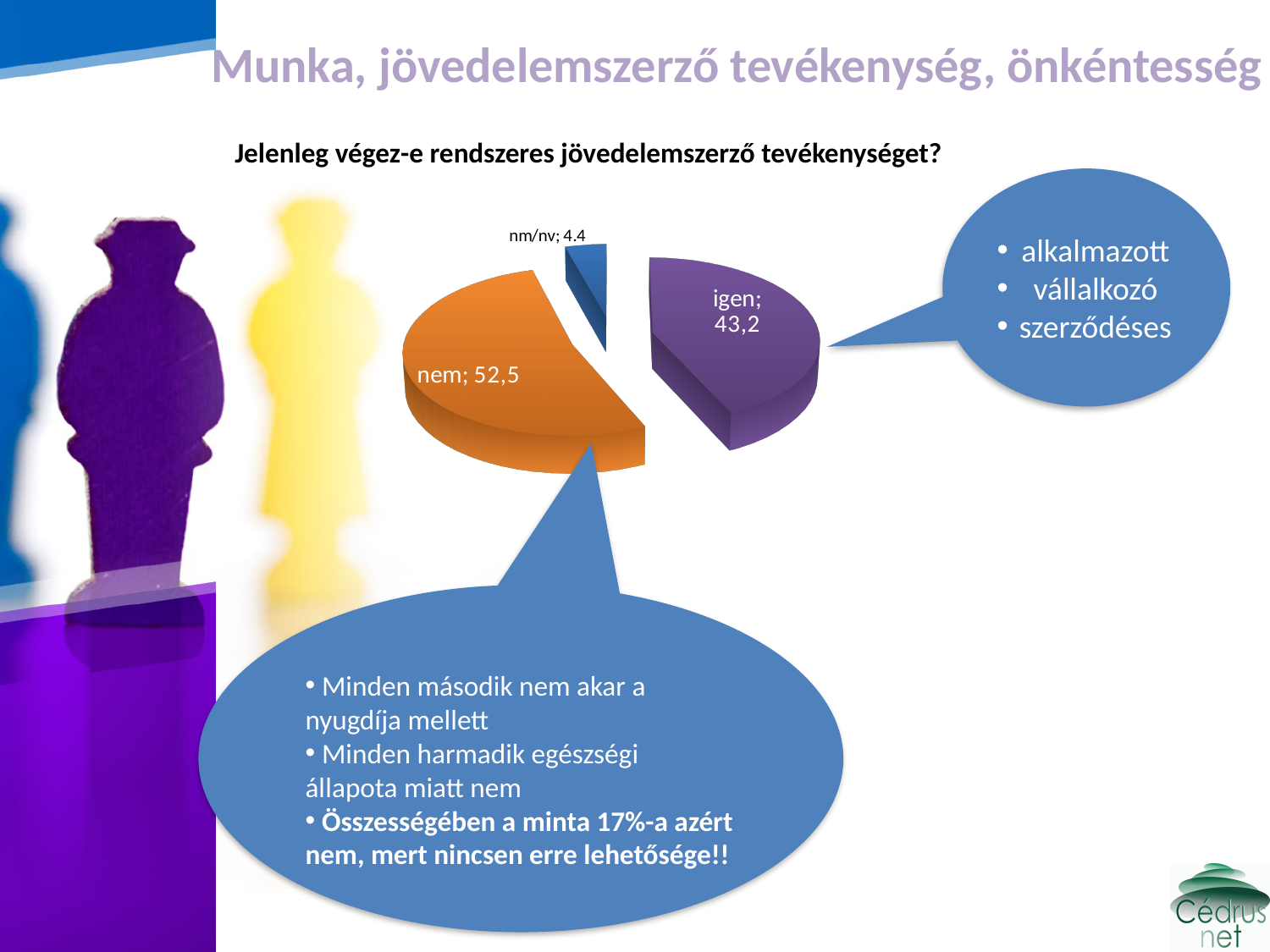
What is the value for the "nem" slice in the pie chart? 52,5 What is the value for the "nm/nv" slice in the pie chart? 4.4 What is the difference between the "nem" and "igen" values in the pie chart? 9,3 What question is the pie chart answering, according to the text above it? Jelenleg végez-e rendszeres jövedelemszerző tevékenységet? How many slices does the pie chart have? 3 Which is larger in the pie chart, "igen" or "nem"? nem What kind of chart is shown on the slide? pie chart Which slice of the pie chart is the largest? nem What colour is the "nem" slice in the pie chart? orange What is the value for the "igen" slice in the pie chart? 43,2 Which slice of the pie chart is the smallest? nm/nv